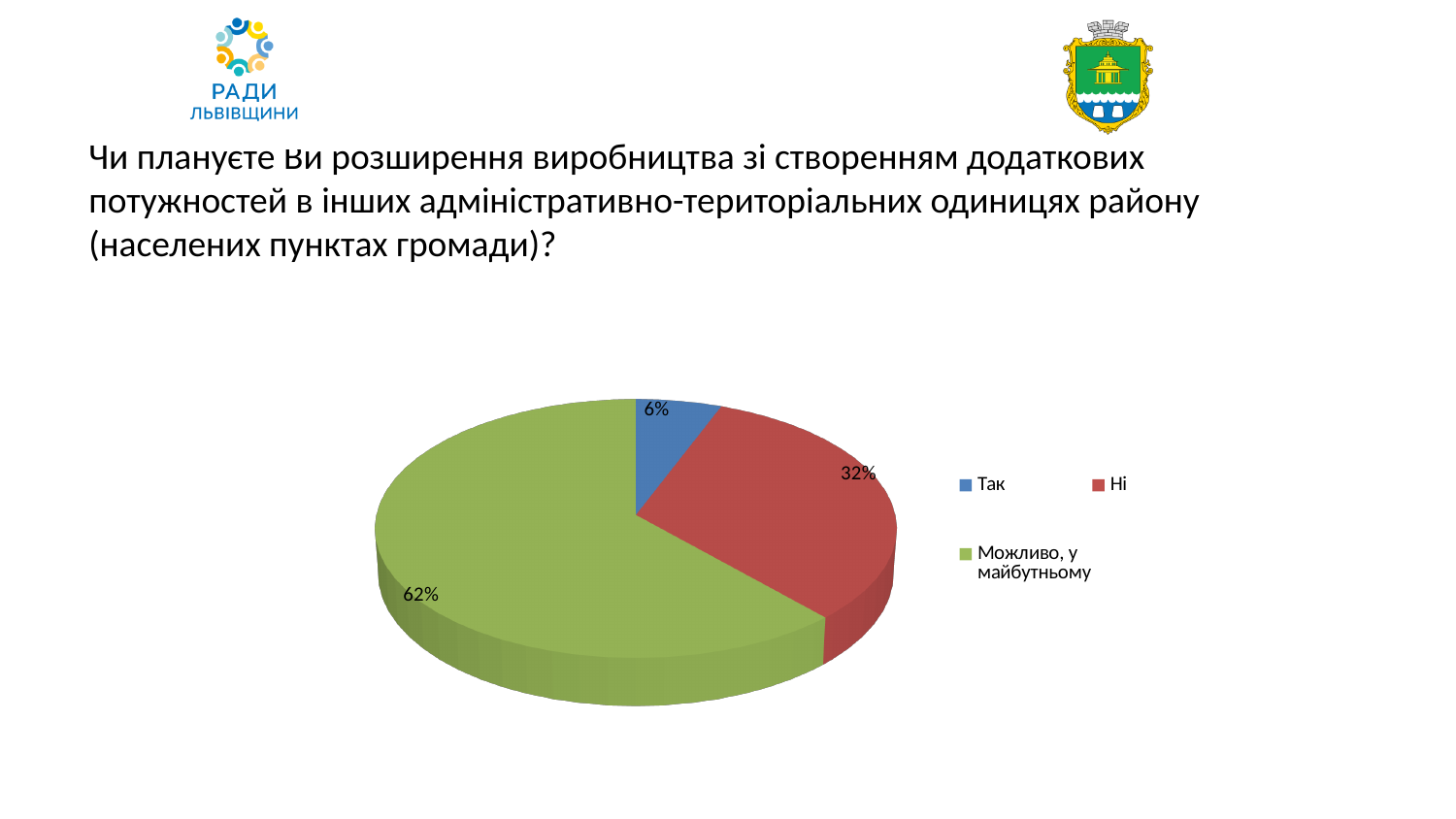
Which category has the smallest slice of the pie? Так What colour is the slice for "Ні"? red What share of the pie does "Так" represent? 6% What share of the pie does "Ні" represent? 32% How many categories does the pie chart have? 3 Which is larger, the share for "Ні" or the share for "Так"? Ні What is the difference in percentage points between "Ні" and "Так"? 26 Which category has the largest slice of the pie? Можливо, у майбутньому What kind of chart is shown on the slide? pie chart How many entries does the legend list? 3 What is the difference in percentage points between "Можливо, у майбутньому" and "Ні"? 30 What share of the pie does "Можливо, у майбутньому" represent? 62%